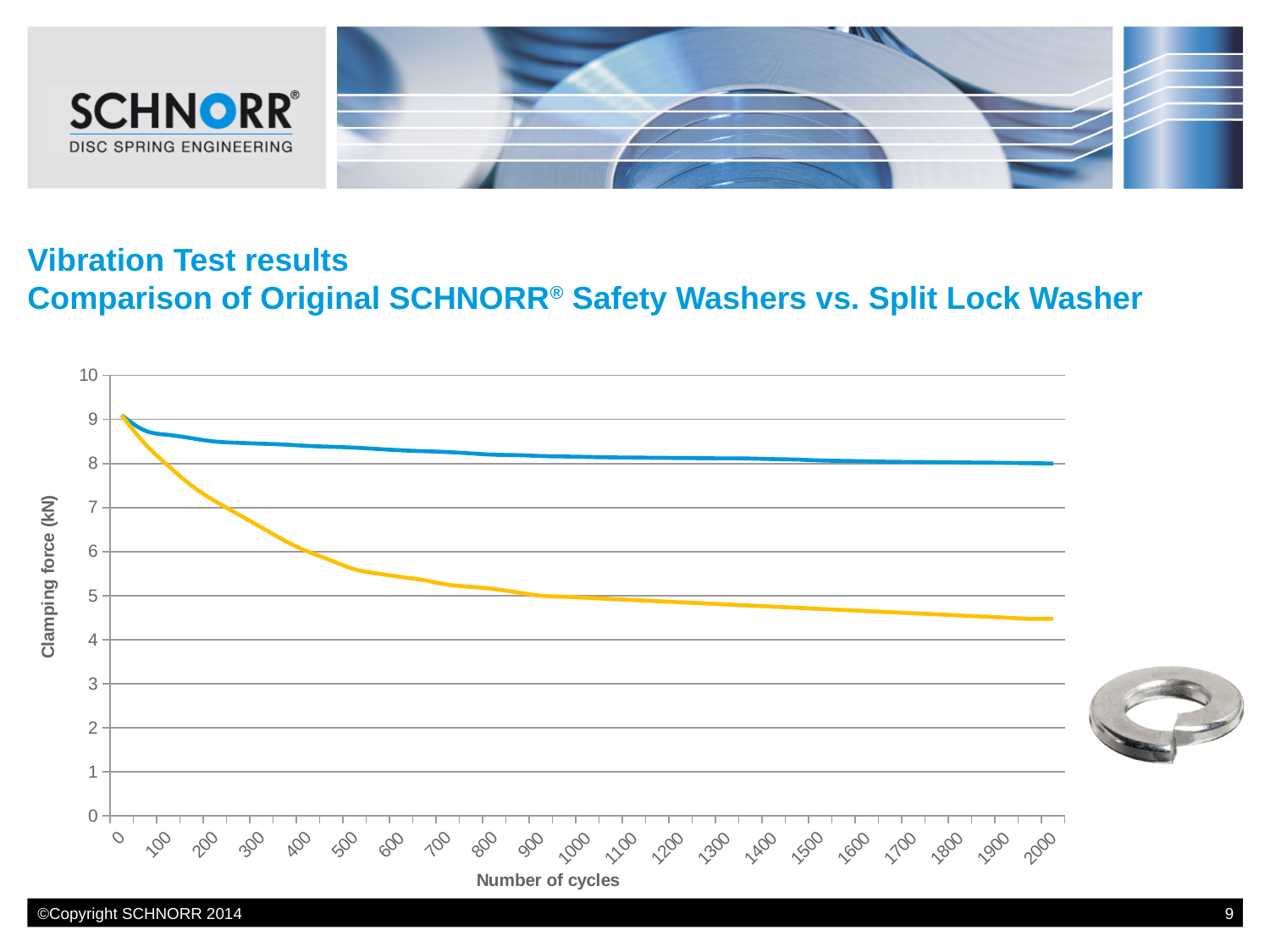
What is the label of the vertical axis? Clamping force (kN) Is the clamping force of the yellow line at 2000 cycles greater or less than 5? less How many lines are plotted on the chart? 2 Is the clamping force of the blue line at 500 cycles greater or less than 8? greater Is the clamping force of the yellow line at 300 cycles greater or less than 7? less At 2000 cycles, which line shows the higher clamping force, the blue line or the yellow line? Blue line What kind of chart is shown on the slide? Line chart Does the yellow line rise or fall as the number of cycles increases? Fall What is the highest value shown on the vertical axis? 10 What is the label of the horizontal axis? Number of cycles Does the blue line rise or fall as the number of cycles increases? Fall